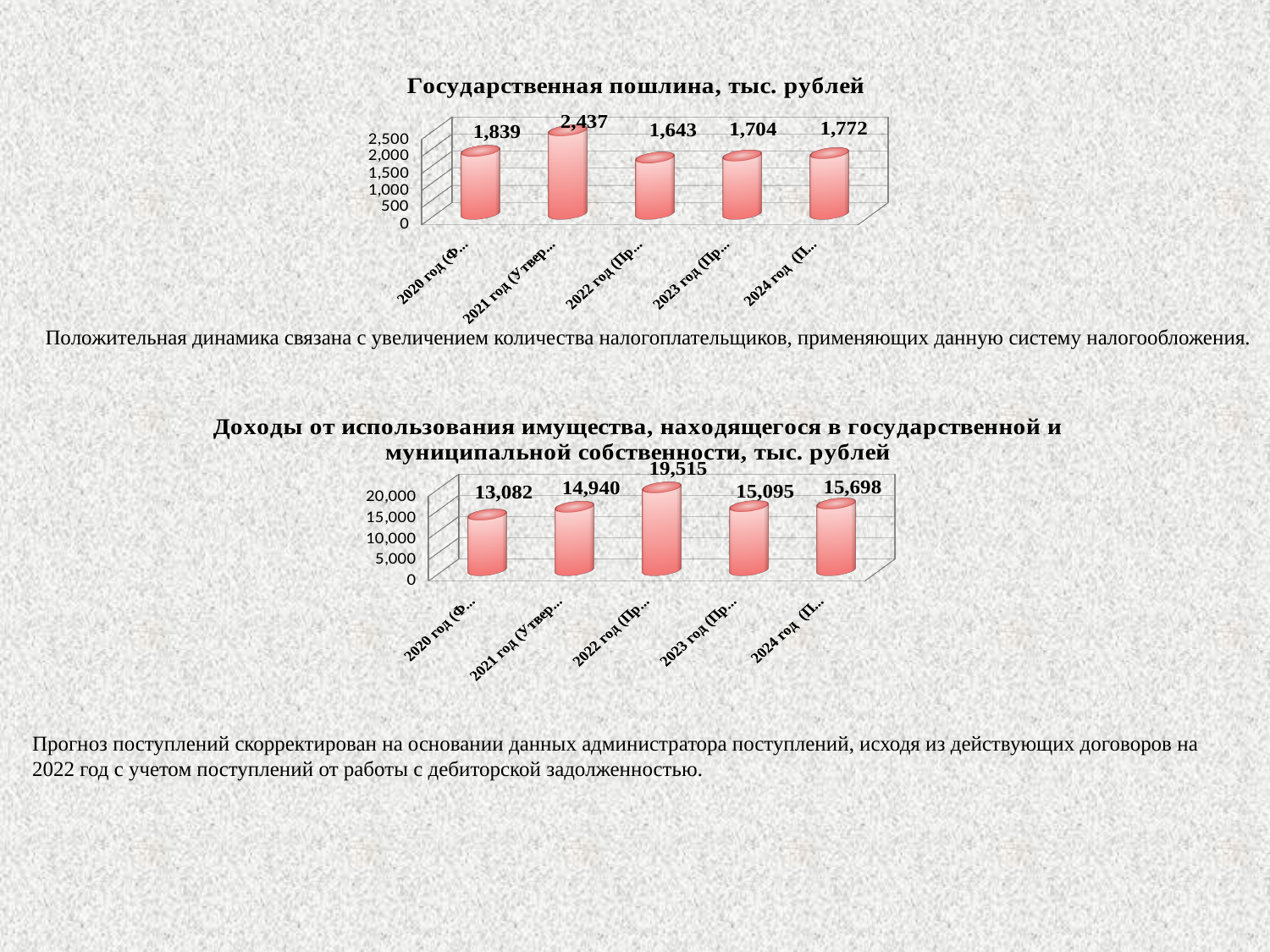
In the bottom chart (Доходы от использования имущества), which year has the highest value? 2022 In the chart titled 'Государственная пошлина, тыс. рублей', what is the difference between the values for 2021 and 2020? 598 In the chart titled 'Государственная пошлина, тыс. рублей', how many bars are plotted? 5 In the bottom chart (Доходы от использования имущества), what is the value for 2020? 13,082 What kind of chart is the top chart on the slide? Bar chart In the bottom chart (Доходы от использования имущества), what is the value for 2022? 19,515 In the bottom chart (Доходы от использования имущества), which is larger, the value for 2023 or the value for 2024? 2024 In the chart titled 'Государственная пошлина, тыс. рублей', what is the value for 2021? 2,437 In the chart titled 'Государственная пошлина, тыс. рублей', which year has the highest value? 2021 In the chart titled 'Государственная пошлина, тыс. рублей', what is the value for 2024? 1,772 In the chart titled 'Государственная пошлина, тыс. рублей', which year has the lowest value? 2022 In the bottom chart (Доходы от использования имущества), what is the difference between the values for 2024 and 2023? 603